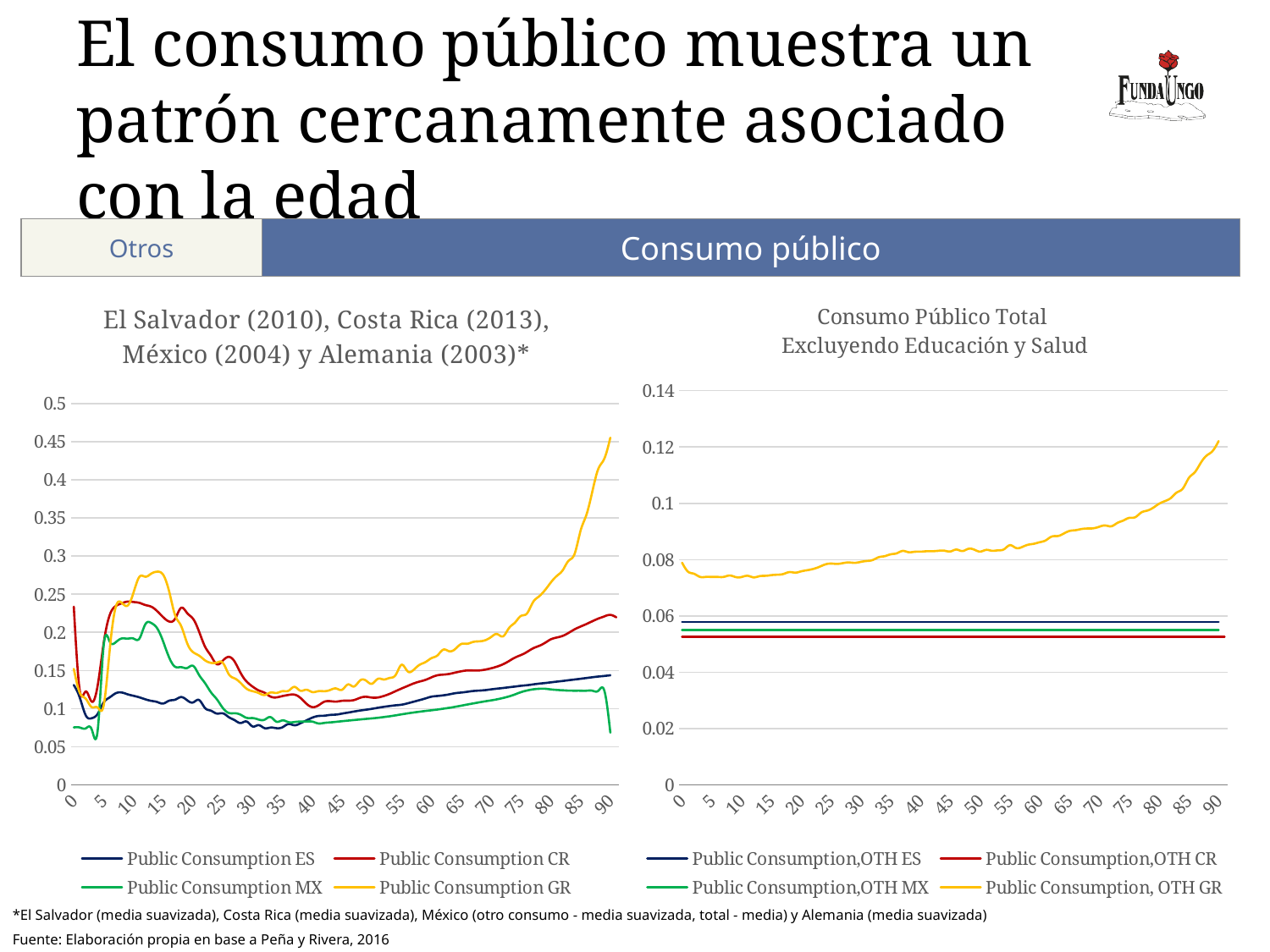
What is the title of the right chart? Consumo Público Total Excluyendo Educación y Salud In the left chart, is the value for Public Consumption CR at age 90 greater or less than 0.2? greater In the left chart, is the value for Public Consumption GR at age 90 greater or less than 0.4? greater How many series does the legend of the left chart list? 4 In the left chart, which series has the highest value at age 90? Public Consumption GR In the left chart, does Public Consumption GR rise or fall between age 40 and age 90? Rises In the right chart, which is larger at age 90: Public Consumption, OTH GR or Public Consumption,OTH ES? Public Consumption, OTH GR In the right chart 'Consumo Público Total Excluyendo Educación y Salud', is the value for Public Consumption, OTH GR at age 90 greater or less than 0.1? greater What kind of chart is the left chart titled 'El Salvador (2010), Costa Rica (2013), México (2004) y Alemania (2003)*'? Line chart How many series does the legend of the right chart 'Consumo Público Total Excluyendo Educación y Salud' list? 4 In the right chart, which series has the highest value at age 90? Public Consumption, OTH GR